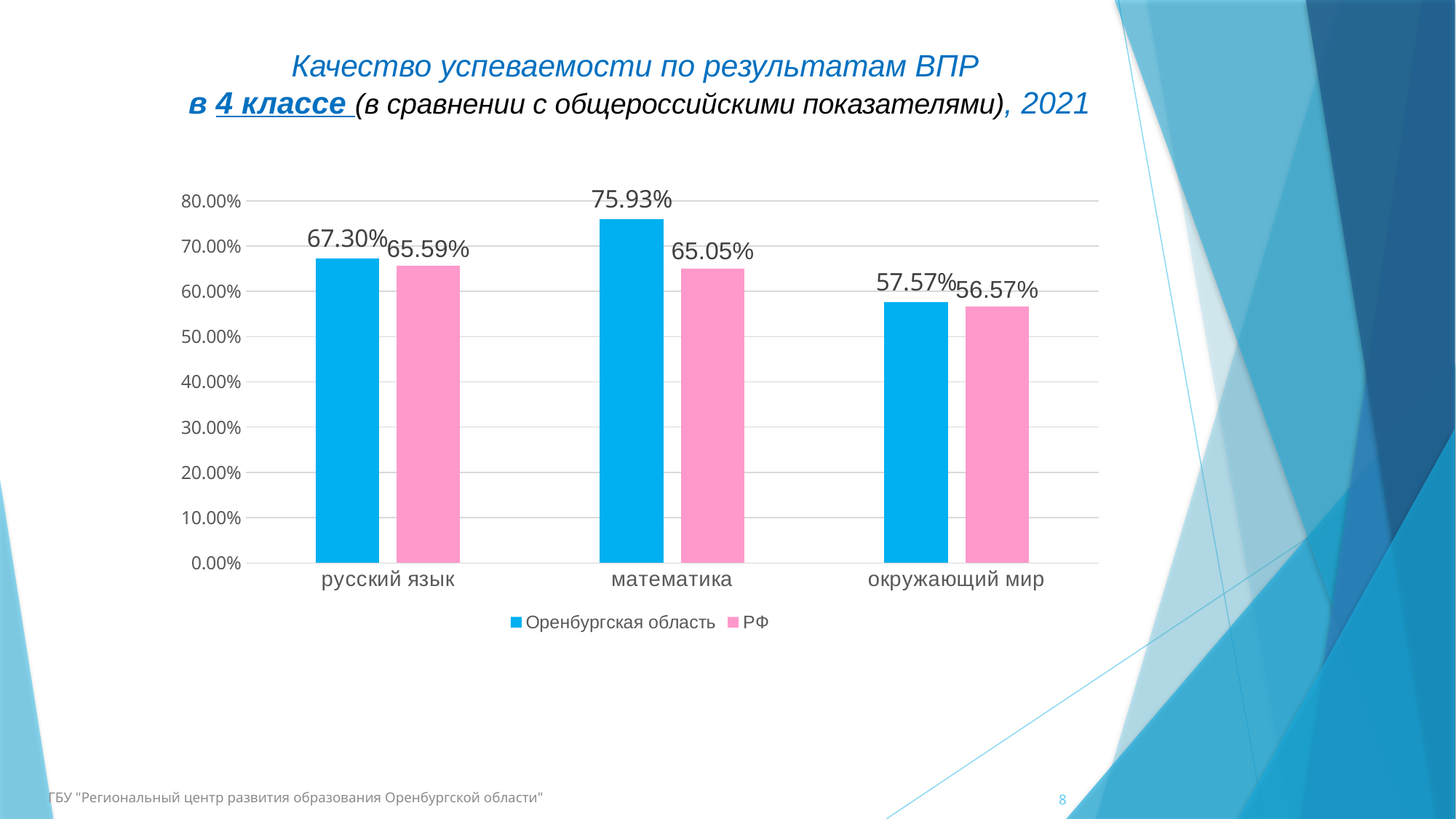
Which is larger in окружающий мир: Оренбургская область or РФ? Оренбургская область What is the difference between Оренбургская область and РФ in русский язык? 1.71% What is the difference between Оренбургская область and РФ in математика? 10.88% What kind of chart is shown on the slide? bar chart Which subject has the highest value for Оренбургская область? математика What is the value for РФ in русский язык? 65.59% How many subject categories are shown on the x axis? 3 How many series does the legend list? 2 What is the value for РФ in окружающий мир? 56.57% Is the value for Оренбургская область in русский язык greater or less than 60.00%? greater What is the value for Оренбургская область in математика? 75.93% Which subject has the lowest value for РФ? окружающий мир